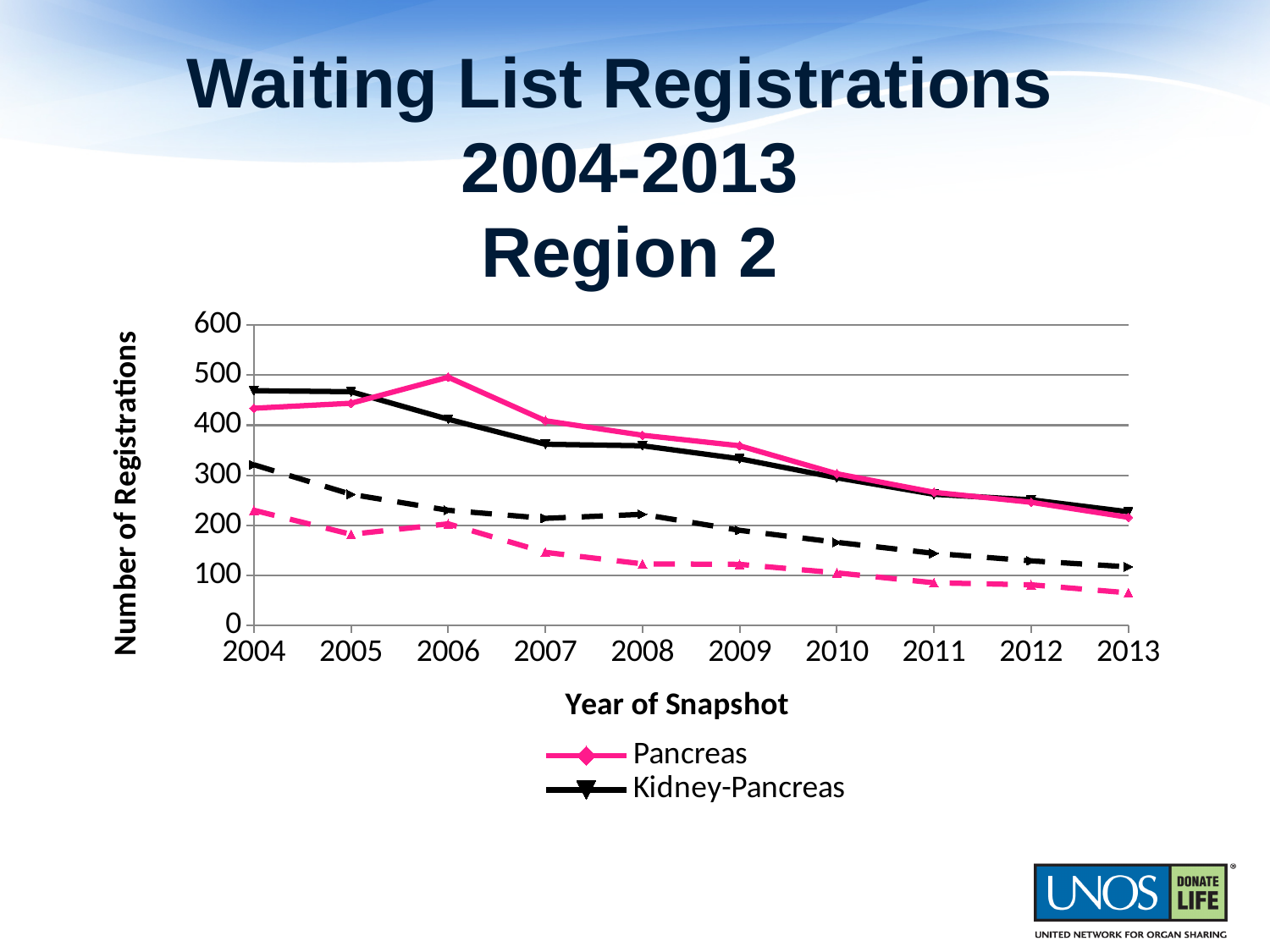
What kind of chart is shown on the slide? Line chart How many series does the legend list? 2 What is the title of the x axis? Year of Snapshot Is the Kidney-Pancreas value for 2007 greater or less than 400? less In which year does the Pancreas line reach its highest value? 2006 In 2006, which series has the larger value, Pancreas or Kidney-Pancreas? Pancreas Is the Pancreas value for 2006 greater or less than 400? greater In 2004, which series has the larger value, Pancreas or Kidney-Pancreas? Kidney-Pancreas In which year is the Kidney-Pancreas line at its lowest value? 2013 From 2006 to 2013, does the Pancreas line rise or fall? Fall How many years are plotted along the x axis? 10 Is the Pancreas value for 2013 greater or less than 300? less